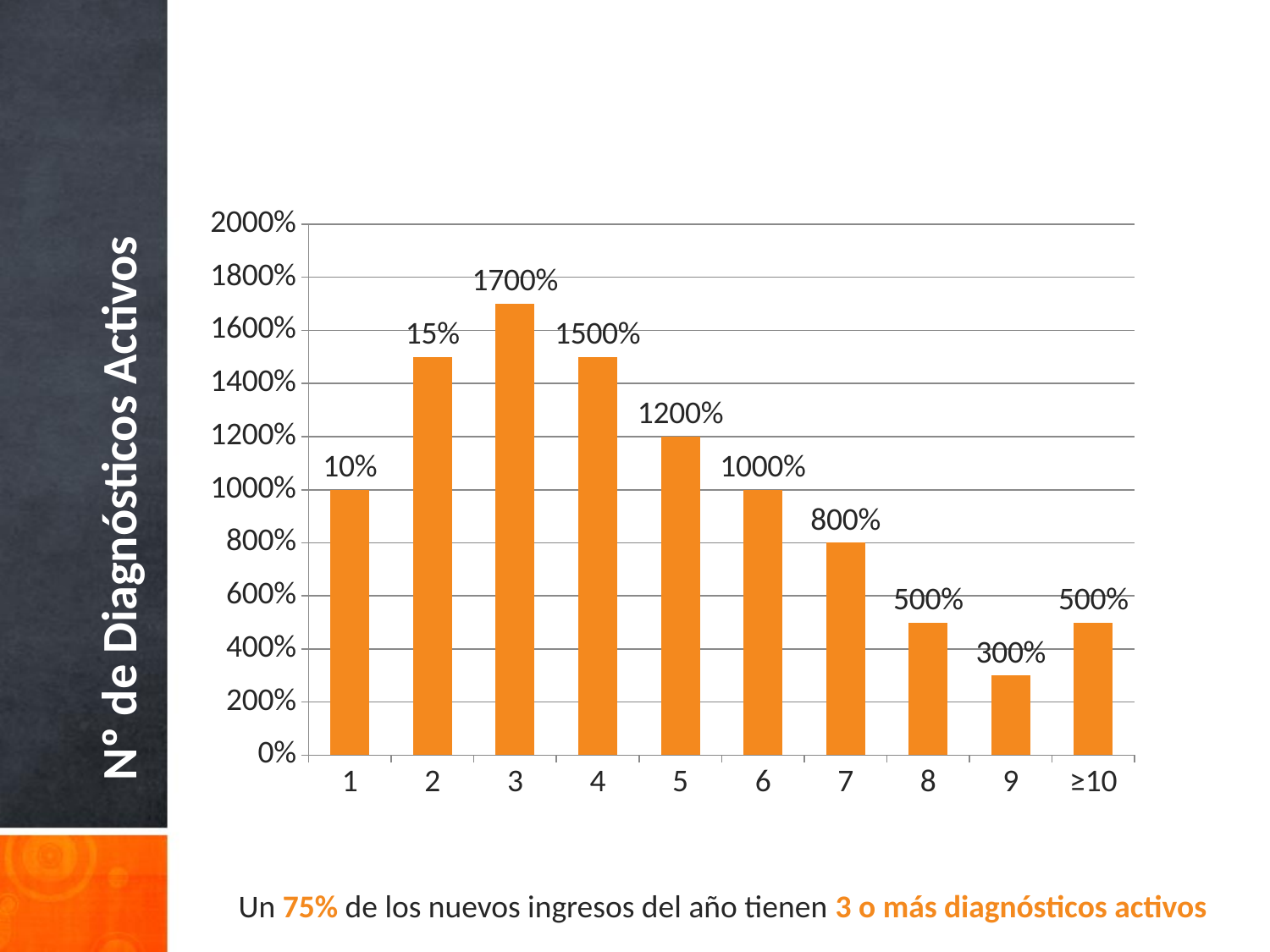
Which is larger, the bar for category 5 or the bar for category 8? 5 How many categories are shown on the x axis? 10 What is the data label shown for category 5? 1200% What is the data label shown for category 7? 800% What is the data label shown for category ≥10? 500% Which category has the highest bar? 3 Do the bars rise or fall from category 3 to category 9? fall What is the difference between the values for category 7 and category 9? 500% Which category has the lowest bar? 9 What is the data label shown for category 3? 1700% What is the difference between the values for category 4 and category 6? 500% What kind of chart is shown on the slide? bar chart